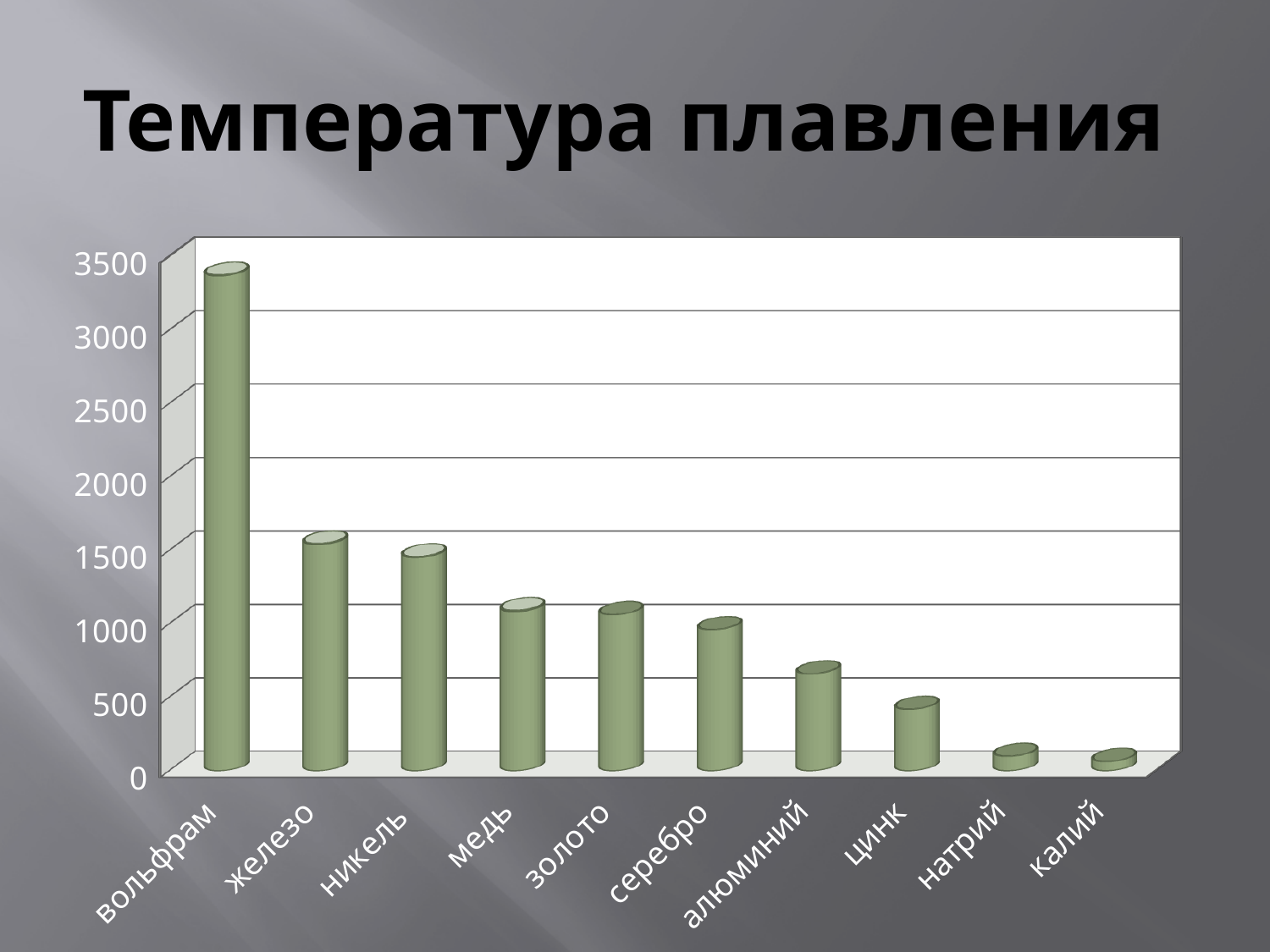
Is the value for алюминий greater or less than 500? greater What kind of chart is shown on the slide? bar chart Is the value for натрий greater or less than 500? less Is the value for цинк greater or less than 500? less Do the values rise or fall moving from left to right along the x axis? fall How many categories (metals) are plotted on the chart? 10 Which has the larger value, вольфрам or железо? вольфрам Which metal has the highest value on the chart? вольфрам Which has the larger value, алюминий or цинк? алюминий What is the title of the chart? Температура плавления